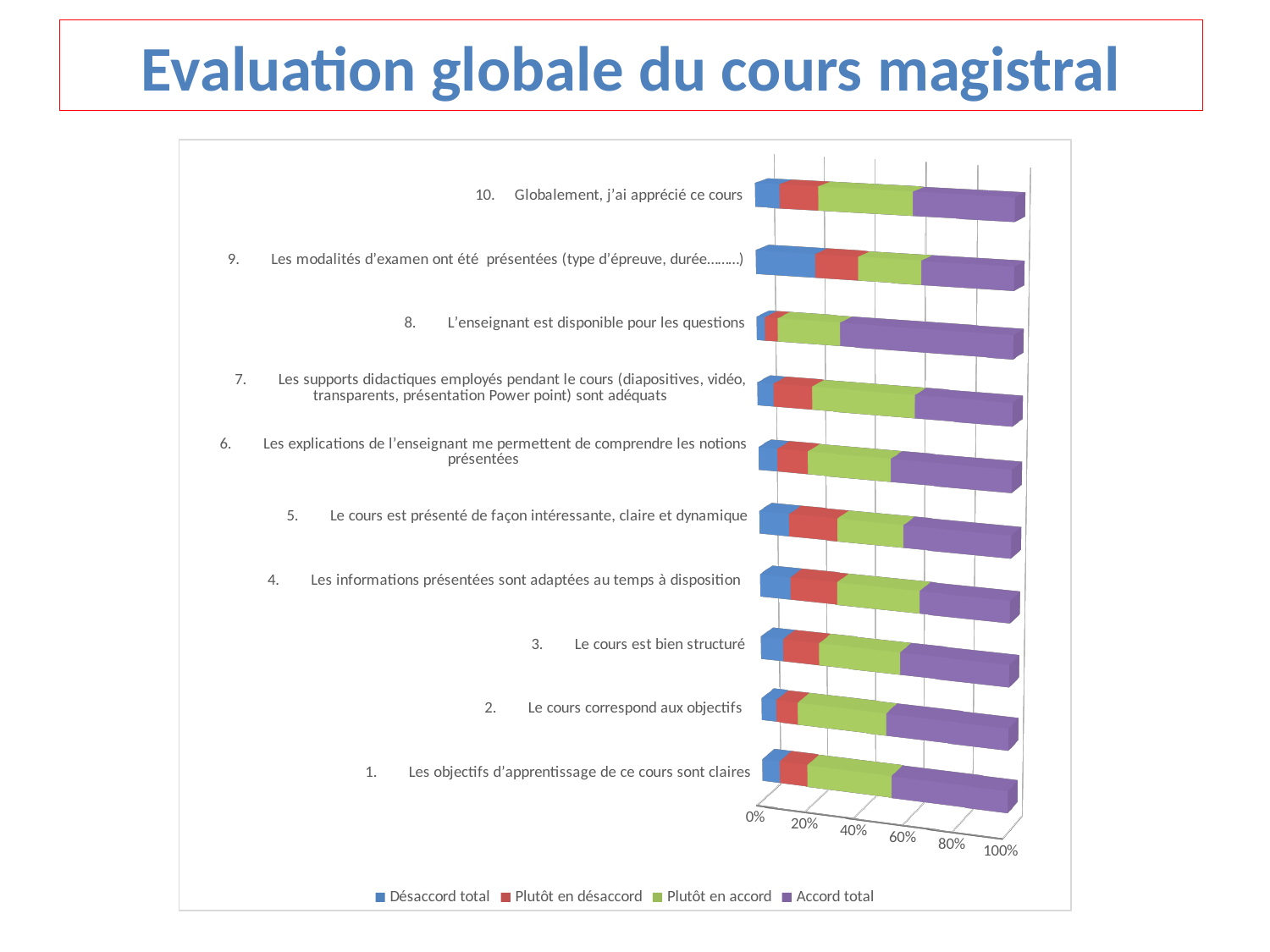
Which statement has the smallest 'Plutôt en désaccord' segment? 8. L'enseignant est disponible pour les questions How many series does the legend list? 4 Which has the larger 'Accord total' segment: statement 8 or statement 9? Statement 8 Is the 'Accord total' share for statement 8 (L'enseignant est disponible pour les questions) greater or less than 40%? greater What is the title of the slide containing the chart? Evaluation globale du cours magistral Which statement has the largest 'Désaccord total' segment? 9. Les modalités d'examen ont été présentées (type d'épreuve, durée……) Which statement has the largest 'Accord total' segment? 8. L'enseignant est disponible pour les questions How many categories (statements) are plotted on the chart? 10 Is the 'Désaccord total' share for statement 10 (Globalement, j'ai apprécié ce cours) greater or less than 20%? less Which statement has the smallest 'Désaccord total' segment? 8. L'enseignant est disponible pour les questions What kind of chart is shown on the slide? Stacked bar chart What are the four series named in the legend? Désaccord total, Plutôt en désaccord, Plutôt en accord, Accord total